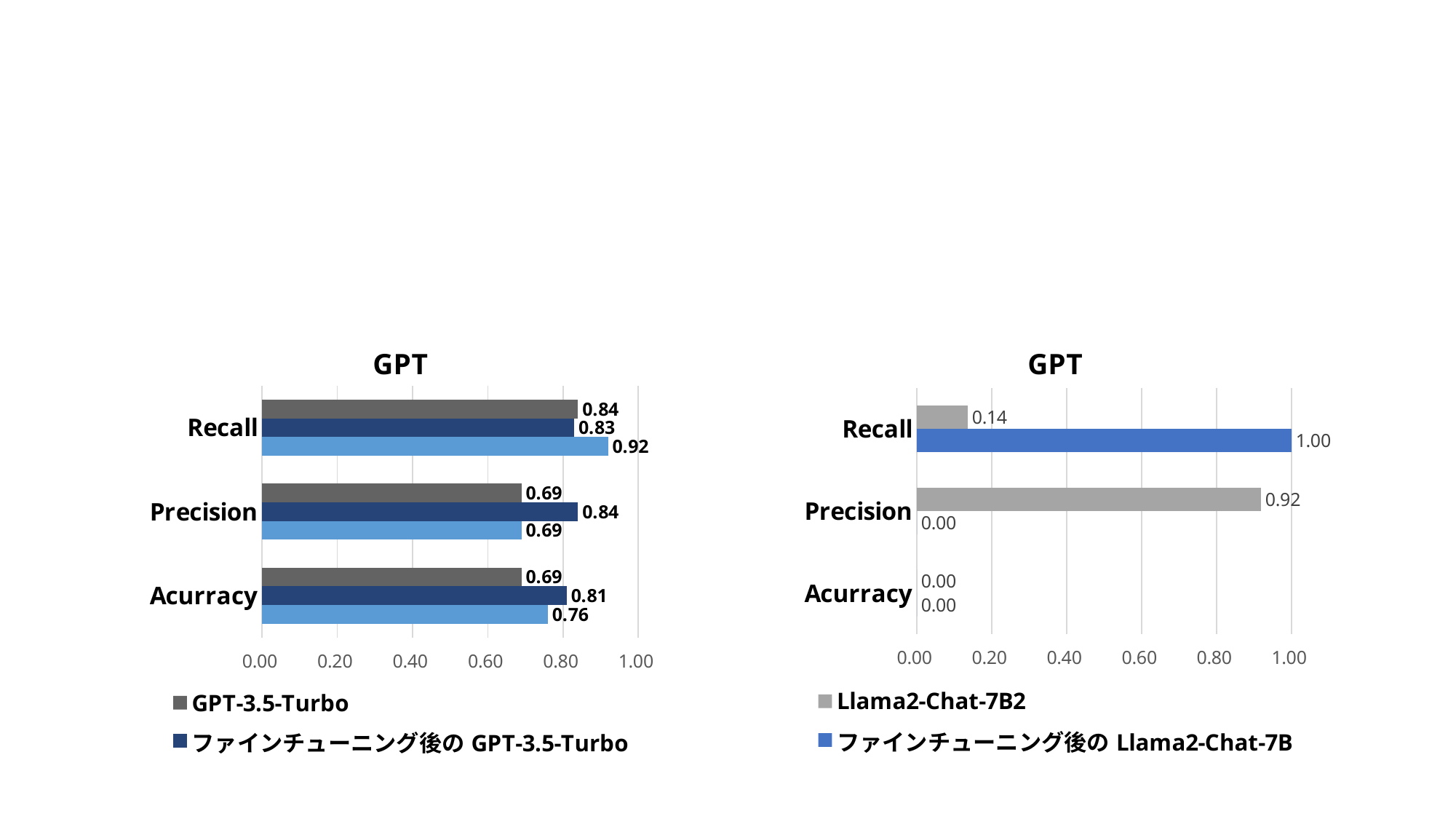
How many series does the legend of the right chart list? 2 In the right chart, for which category does Llama2-Chat-7B2 have its highest value? Precision In the left chart, what is the Recall value for GPT-3.5-Turbo? 0.84 In the left chart, what is the difference between the Acurracy values of ファインチューニング後の GPT-3.5-Turbo and GPT-3.5-Turbo? 0.12 In the left chart, which has the higher Precision value: GPT-3.5-Turbo or ファインチューニング後の GPT-3.5-Turbo? ファインチューニング後の GPT-3.5-Turbo In the right chart, what is the Recall value for ファインチューニング後の Llama2-Chat-7B? 1.00 In the right chart, what is the difference between the Recall values of ファインチューニング後の Llama2-Chat-7B and Llama2-Chat-7B2? 0.86 In the left chart, what is the Precision value for ファインチューニング後の GPT-3.5-Turbo? 0.84 How many categories are shown on the y axis of the left chart? 3 In the right chart, what is the Recall value for Llama2-Chat-7B2? 0.14 In the left chart, what is the Acurracy value for ファインチューニング後の GPT-3.5-Turbo? 0.81 In the right chart, what is the Precision value for Llama2-Chat-7B2? 0.92